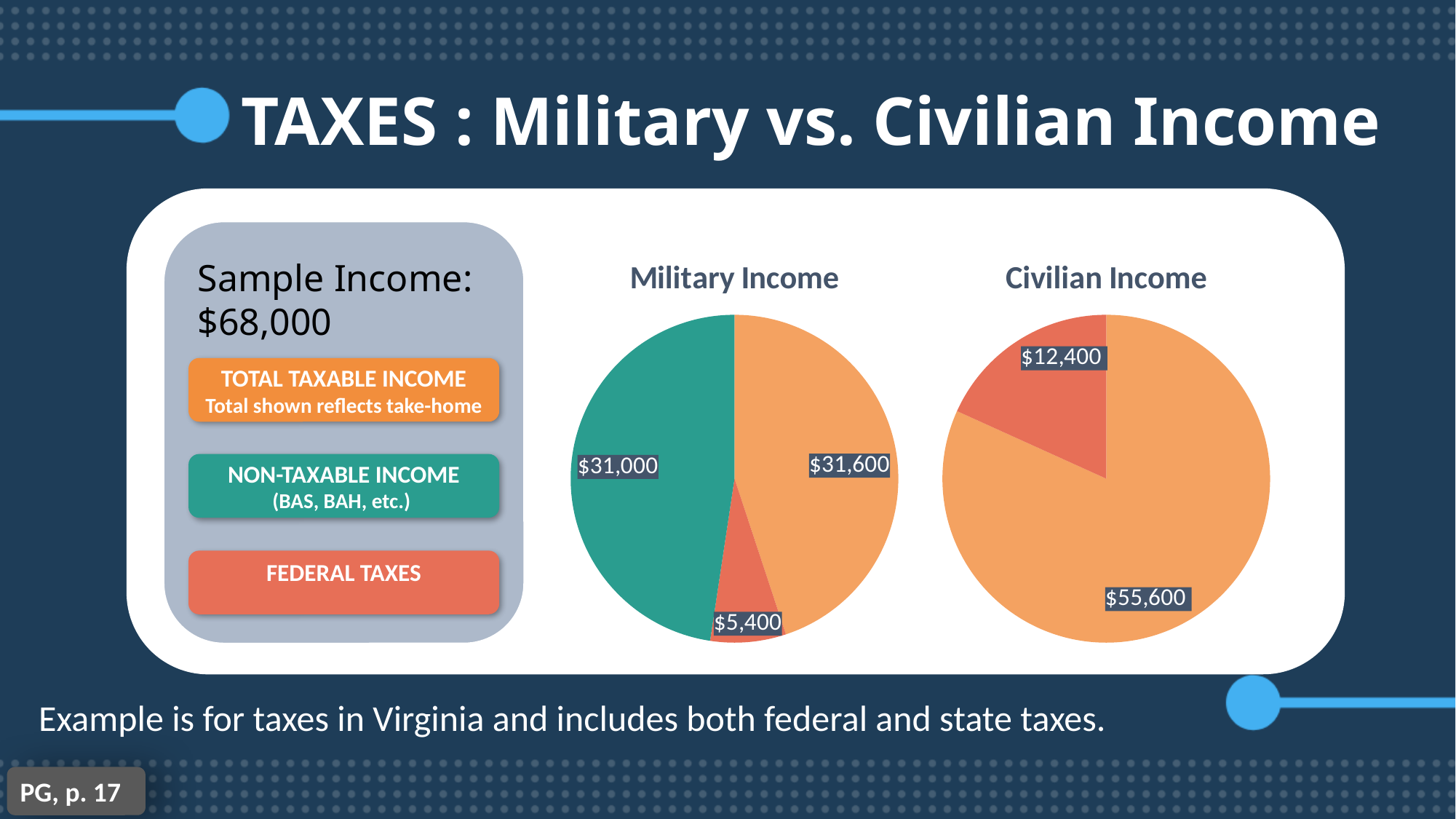
In the Military Income chart, what is the value of the Total Taxable Income slice? $31,600 How many slices does the Civilian Income chart have? 2 In the Civilian Income chart, what is the value of the Total Taxable Income slice? $55,600 In the Military Income chart, what is the difference between Total Taxable Income and Non-Taxable Income? $600 In the Military Income chart, what is the value of the Non-Taxable Income slice? $31,000 What type of chart is the Military Income chart? Pie chart What is the difference between the Federal Taxes values in the Civilian Income chart and the Military Income chart? $7,000 Which is larger: Federal Taxes in the Military Income chart or Federal Taxes in the Civilian Income chart? Civilian Income In the Military Income chart, what is the value of the Federal Taxes slice? $5,400 In the Civilian Income chart, which slice is the largest? Total Taxable Income In the Military Income chart, which slice is the smallest? Federal Taxes In the Civilian Income chart, what is the value of the Federal Taxes slice? $12,400